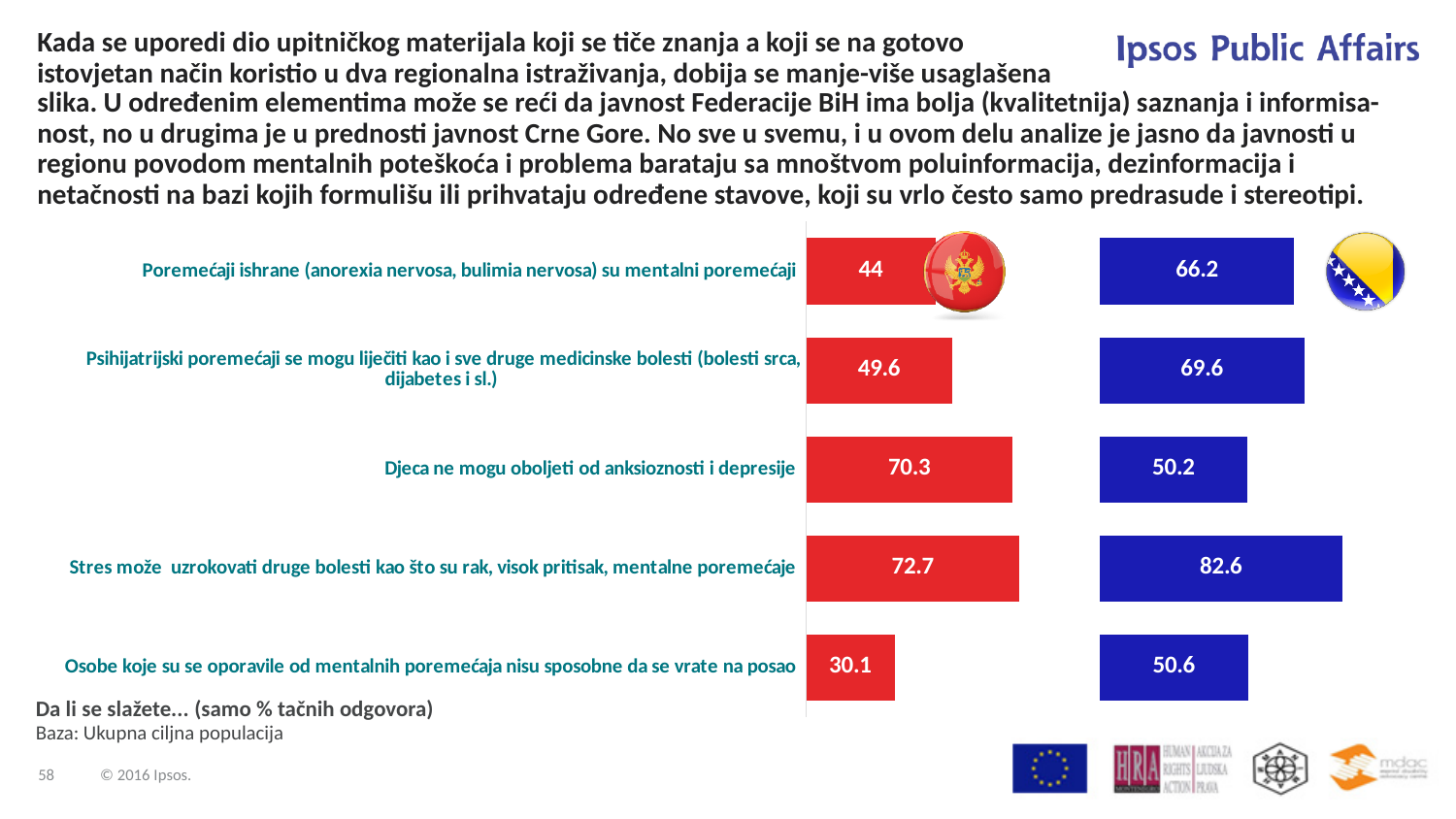
Which statement has the highest value among the red bars (Montenegro flag)? Stres može uzrokovati druge bolesti kao što su rak, visok pritisak, mentalne poremećaje What value is shown on the blue bar (Bosnia and Herzegovina flag) for "Stres može uzrokovati druge bolesti kao što su rak, visok pritisak, mentalne poremećaje"? 82.6 What value is shown on the red bar (Montenegro flag) for "Djeca ne mogu oboljeti od anksioznosti i depresije"? 70.3 What is the difference between the blue bar (Bosnia and Herzegovina flag) and the red bar (Montenegro flag) for "Psihijatrijski poremećaji se mogu liječiti kao i sve druge medicinske bolesti (bolesti srca, dijabetes i sl.)"? 20 How many statements (categories) are shown in the chart? 5 What value is shown on the red bar (Montenegro flag) for "Osobe koje su se oporavile od mentalnih poremećaja nisu sposobne da se vrate na posao"? 30.1 Which statement has the lowest value among the blue bars (Bosnia and Herzegovina flag)? Djeca ne mogu oboljeti od anksioznosti i depresije How many series (bar colours) does the chart show? 2 What is the difference between the red bar (Montenegro flag) and the blue bar (Bosnia and Herzegovina flag) for "Osobe koje su se oporavile od mentalnih poremećaja nisu sposobne da se vrate na posao"? 20.5 For "Djeca ne mogu oboljeti od anksioznosti i depresije", which is larger: the red bar (Montenegro flag) or the blue bar (Bosnia and Herzegovina flag)? The red bar (Montenegro flag) What type of chart is shown on the slide? Bar chart What value is shown on the blue bar (Bosnia and Herzegovina flag) for "Poremećaji ishrane (anorexia nervosa, bulimia nervosa) su mentalni poremećaji"? 66.2